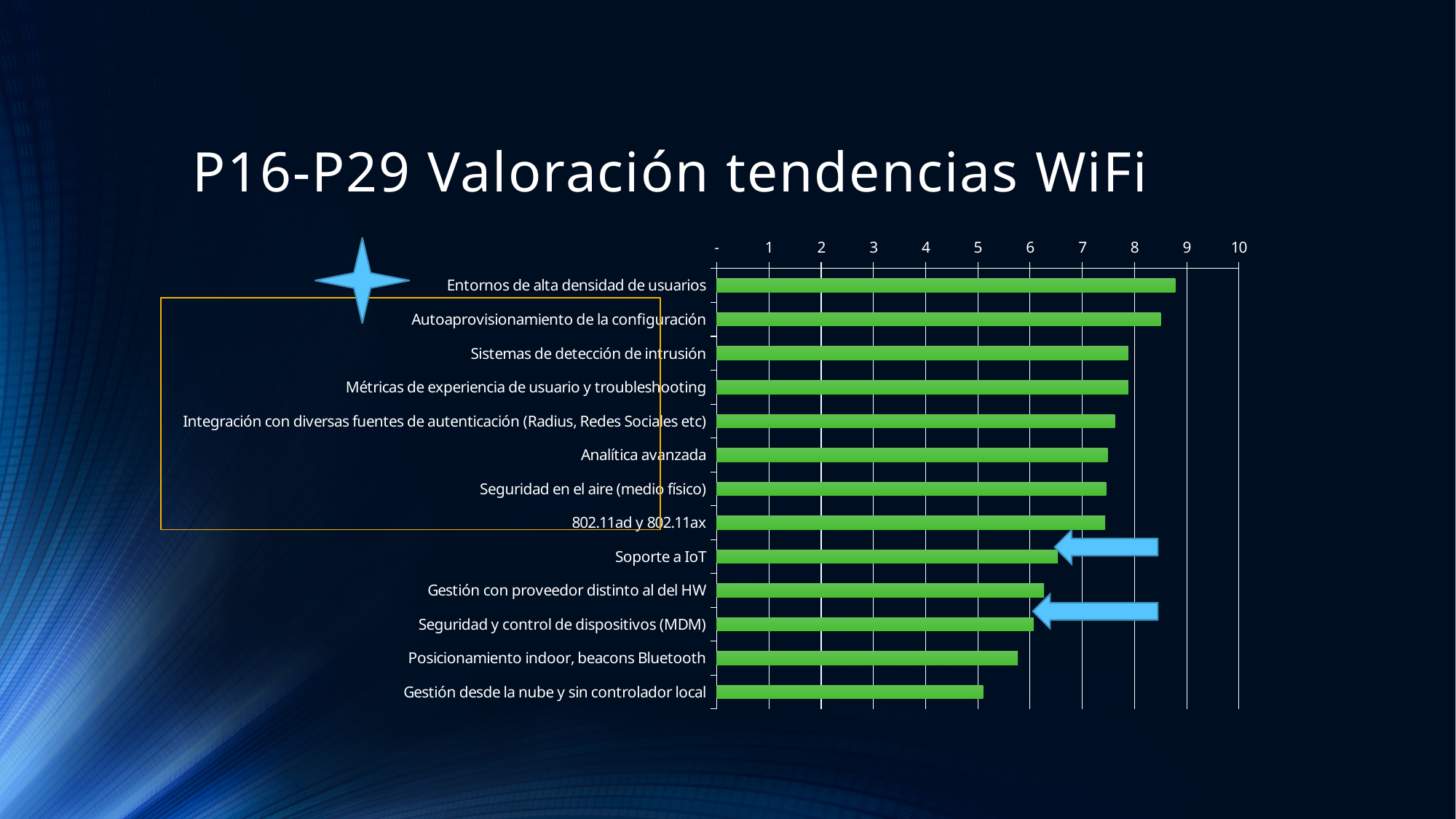
Which has a larger value, Posicionamiento indoor, beacons Bluetooth or Gestión desde la nube y sin controlador local? Posicionamiento indoor, beacons Bluetooth How many categories are plotted in the chart? 13 Is the value for Analítica avanzada greater or less than 7? greater Do the bar values increase or decrease going from the top category to the bottom category? decrease Which category has the highest value in the chart? Entornos de alta densidad de usuarios What is the title of the slide containing the chart? P16-P29 Valoración tendencias WiFi Is the value for Gestión desde la nube y sin controlador local greater or less than 6? less Which has a larger value, Autoaprovisionamiento de la configuración or Soporte a IoT? Autoaprovisionamiento de la configuración Is the value for Soporte a IoT greater or less than 7? less Which category has the lowest value in the chart? Gestión desde la nube y sin controlador local What kind of chart is shown on the slide? bar chart